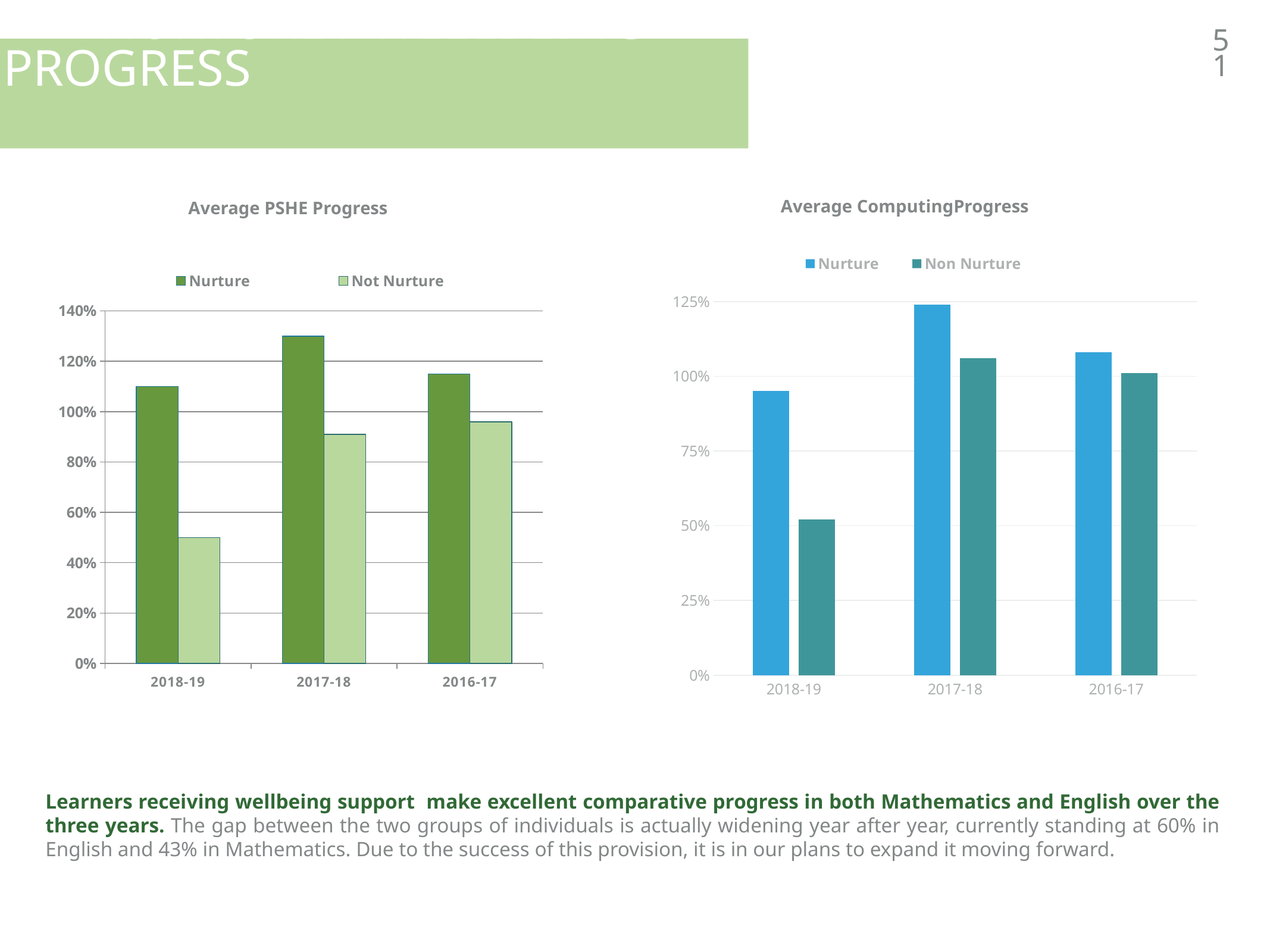
In the Average ComputingProgress chart, which year has the highest Nurture value? 2017-18 How many series does the legend of the Average ComputingProgress chart list? 2 In the Average ComputingProgress chart, is the Nurture value for 2017-18 greater or less than 100%? greater In the Average PSHE Progress chart, is the Not Nurture value for 2018-19 greater or less than 60%? less In the Average PSHE Progress chart, which is larger for 2016-17, Nurture or Not Nurture? Nurture What kind of chart is the Average PSHE Progress chart? bar chart In the Average ComputingProgress chart, which year has the lowest Non Nurture value? 2018-19 In the Average PSHE Progress chart, is the Nurture value for 2017-18 greater or less than 120%? greater In the Average PSHE Progress chart, which year has the lowest Not Nurture value? 2018-19 In the Average PSHE Progress chart, which year has the highest Nurture value? 2017-18 How many year categories are shown on the x axis of the Average PSHE Progress chart? 3